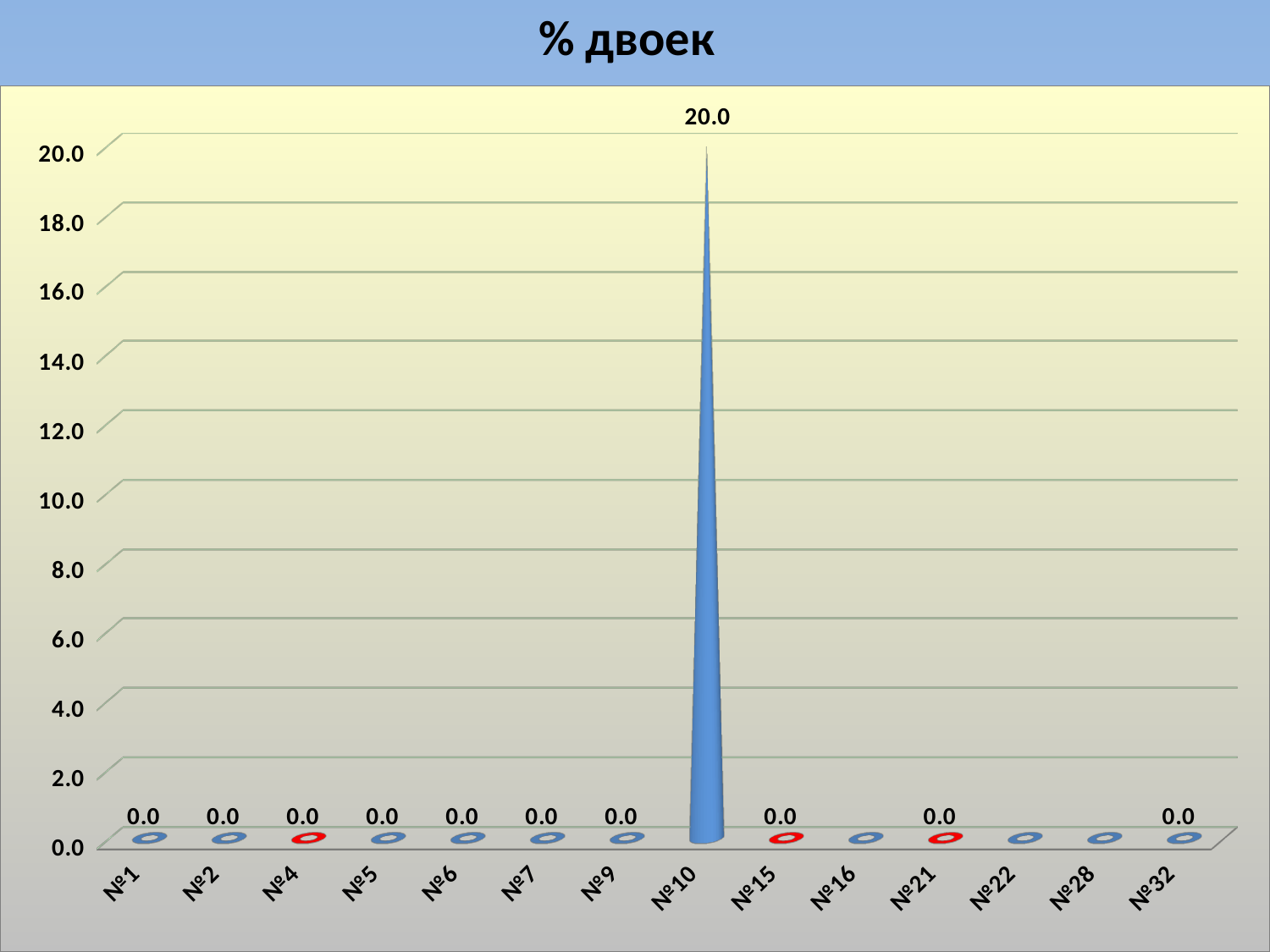
How many categories are shown on the x axis of the chart? 14 What kind of chart is shown on the slide? bar chart What is the highest value shown on the vertical axis of the chart? 20.0 What is the value for №15 in the chart? 0.0 What is the title of the chart? % двоек Which is larger, the value for №10 or the value for №16? №10 Is the value for №10 greater or less than 10.0? greater Is the value for №22 greater or less than 2.0? less What is the difference between the values for №10 and №9? 20.0 What is the value for №1 in the chart? 0.0 What is the value for №10 in the chart? 20.0 Which category has the highest value in the chart? №10